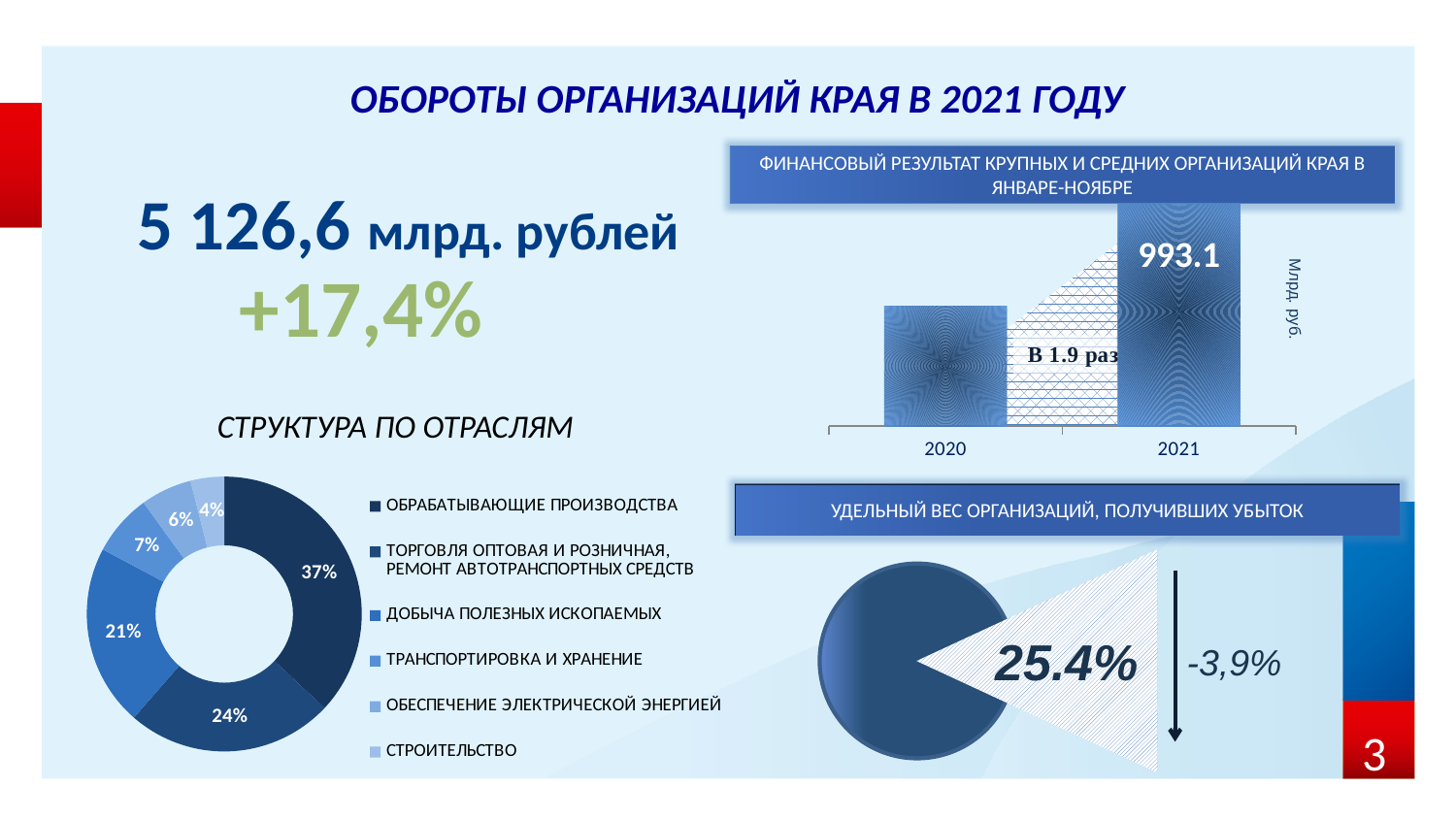
In the chart 'СТРУКТУРА ПО ОТРАСЛЯМ', what share does ДОБЫЧА ПОЛЕЗНЫХ ИСКОПАЕМЫХ have? 21% In the chart 'СТРУКТУРА ПО ОТРАСЛЯМ', which is larger: ДОБЫЧА ПОЛЕЗНЫХ ИСКОПАЕМЫХ or ОБЕСПЕЧЕНИЕ ЭЛЕКТРИЧЕСКОЙ ЭНЕРГИЕЙ? ДОБЫЧА ПОЛЕЗНЫХ ИСКОПАЕМЫХ In the chart 'СТРУКТУРА ПО ОТРАСЛЯМ', what is the difference in percentage points between ТОРГОВЛЯ ОПТОВАЯ И РОЗНИЧНАЯ and ТРАНСПОРТИРОВКА И ХРАНЕНИЕ? 17 percentage points In the chart 'ФИНАНСОВЫЙ РЕЗУЛЬТАТ КРУПНЫХ И СРЕДНИХ ОРГАНИЗАЦИЙ КРАЯ В ЯНВАРЕ-НОЯБРЕ', which year has the higher bar, 2020 or 2021? 2021 In the chart 'СТРУКТУРА ПО ОТРАСЛЯМ', what share does ОБРАБАТЫВАЮЩИЕ ПРОИЗВОДСТВА have? 37% In the chart 'СТРУКТУРА ПО ОТРАСЛЯМ', which sector has the largest share? ОБРАБАТЫВАЮЩИЕ ПРОИЗВОДСТВА In the chart 'ФИНАНСОВЫЙ РЕЗУЛЬТАТ КРУПНЫХ И СРЕДНИХ ОРГАНИЗАЦИЙ КРАЯ В ЯНВАРЕ-НОЯБРЕ', what is the value for 2021? 993.1 In the chart 'СТРУКТУРА ПО ОТРАСЛЯМ', which sector has the smallest share? СТРОИТЕЛЬСТВО What kind of chart is 'СТРУКТУРА ПО ОТРАСЛЯМ'? Donut (pie) chart How many sectors does the legend of the chart 'СТРУКТУРА ПО ОТРАСЛЯМ' list? 6 In the chart 'СТРУКТУРА ПО ОТРАСЛЯМ', what share does СТРОИТЕЛЬСТВО have? 4% What kind of chart is 'ФИНАНСОВЫЙ РЕЗУЛЬТАТ КРУПНЫХ И СРЕДНИХ ОРГАНИЗАЦИЙ КРАЯ В ЯНВАРЕ-НОЯБРЕ'? Bar chart